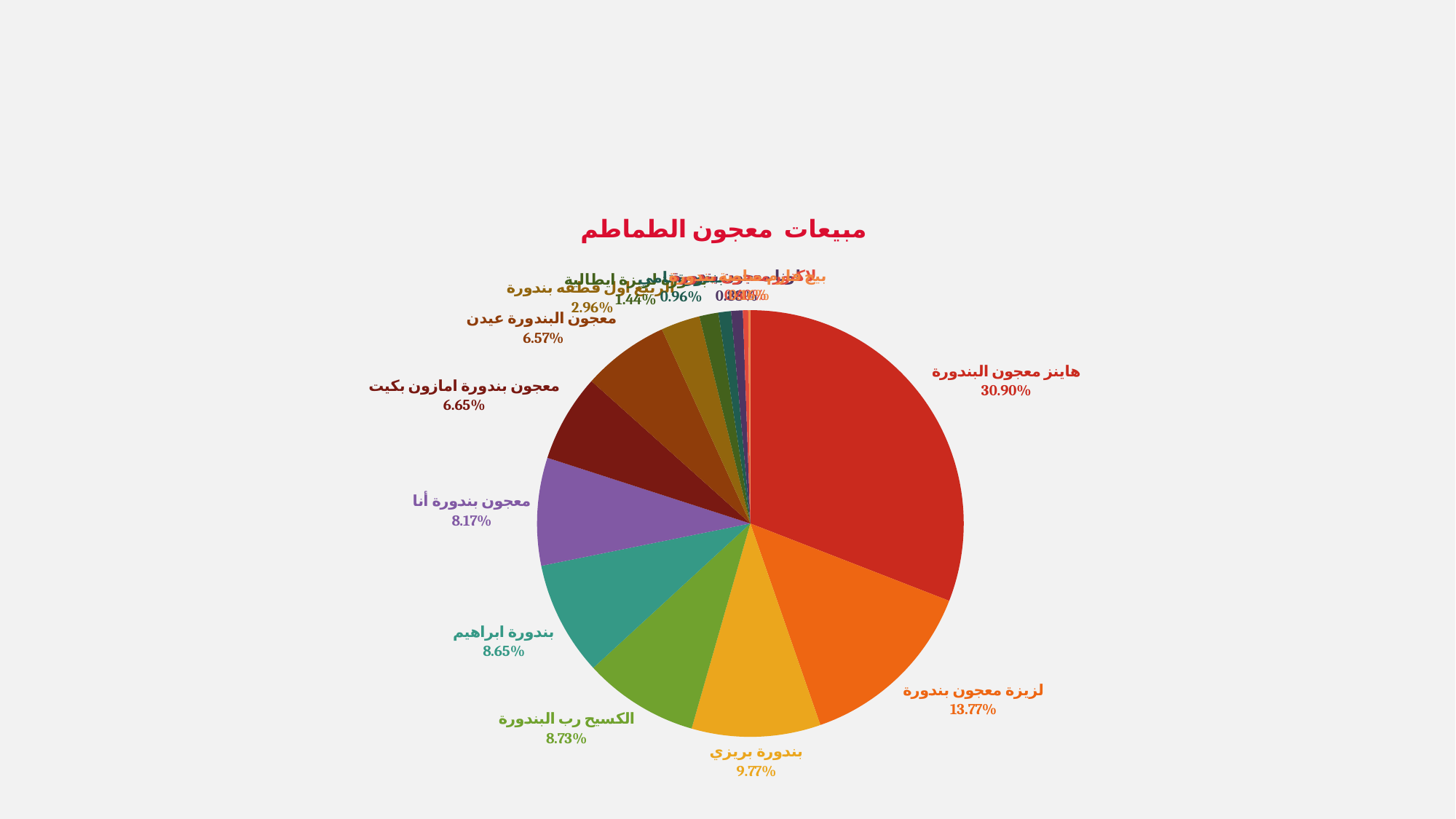
What is the value shown for الكسيح رب البندورة? 8.73% What is the title of the chart? مبيعات معجون الطماطم What is the value shown for معجون بندورة أنا? 8.17% What kind of chart is shown on the slide? pie chart What is the value shown for بندورة بربزي? 9.77% What share of the pie does هاينز معجون البندورة hold? 30.90% Which is larger, the slice for لزيزة معجون بندورة or the slice for بندورة بربزي? لزيزة معجون بندورة What is the value shown for معجون بندورة امازون بكيت? 6.65% What is the value shown for بندورة ابراهيم? 8.65% Which category has the largest slice of the pie? هاينز معجون البندورة What is the difference between the values for هاينز معجون البندورة and لزيزة معجون بندورة? 17.13% What is the value shown for لزيزة معجون بندورة? 13.77%